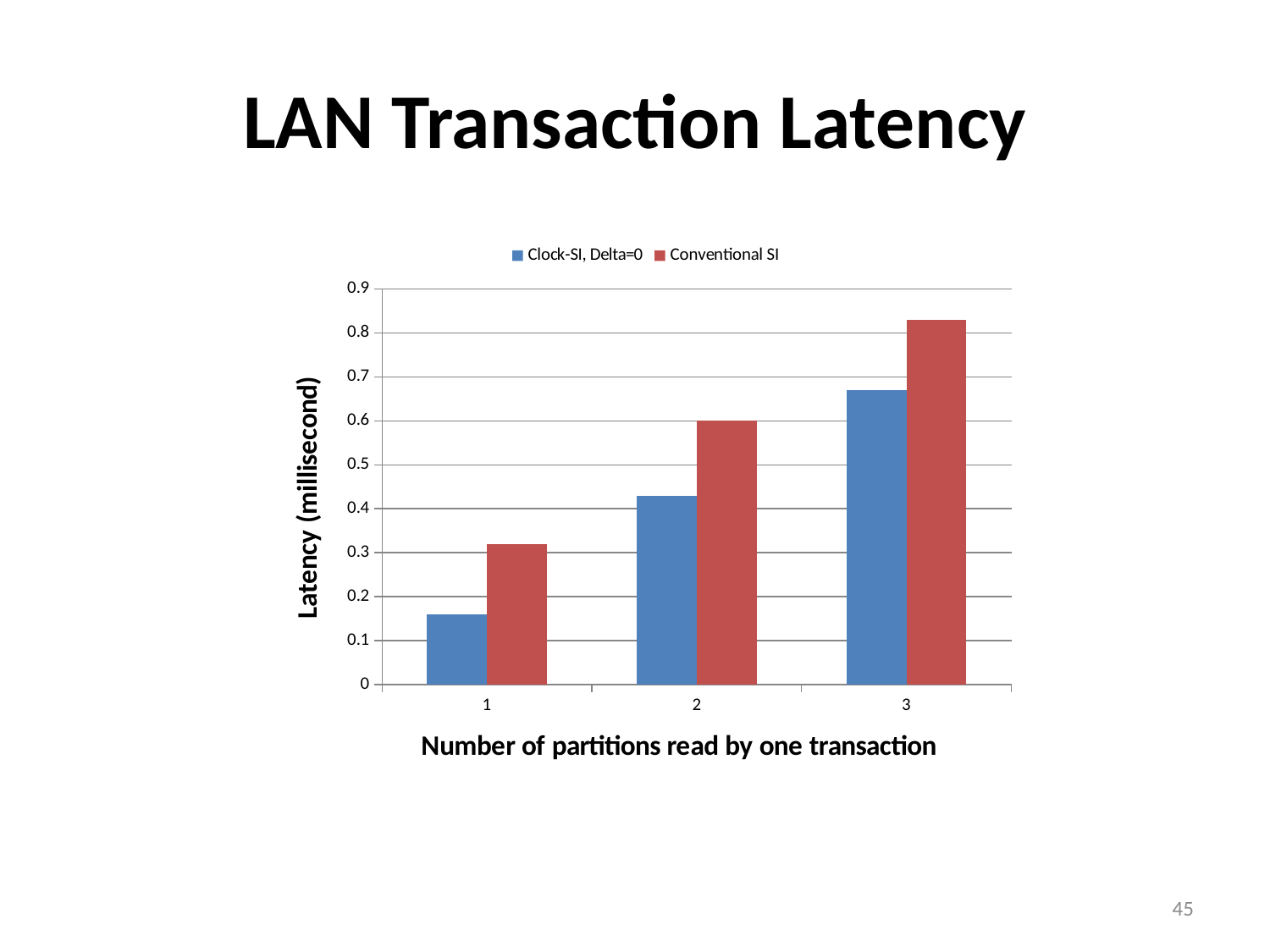
Is the Clock-SI, Delta=0 latency for 2 partitions greater or less than 0.5 milliseconds? less What kind of chart is shown on the slide? bar chart For Clock-SI, Delta=0, at which number of partitions is the latency lowest? 1 How many categories are shown on the x axis? 3 What is the label of the y axis? Latency (millisecond) For Conventional SI, at which number of partitions is the latency highest? 3 Does the latency for Clock-SI, Delta=0 rise or fall as the number of partitions increases from 1 to 3? rise Which colour represents Conventional SI in the chart? red Is the Clock-SI, Delta=0 latency for 1 partition greater or less than 0.2 milliseconds? less Is the Conventional SI latency for 3 partitions greater or less than 0.8 milliseconds? greater How many series does the legend list? 2 Which series has the higher latency when 3 partitions are read by one transaction, Clock-SI, Delta=0 or Conventional SI? Conventional SI